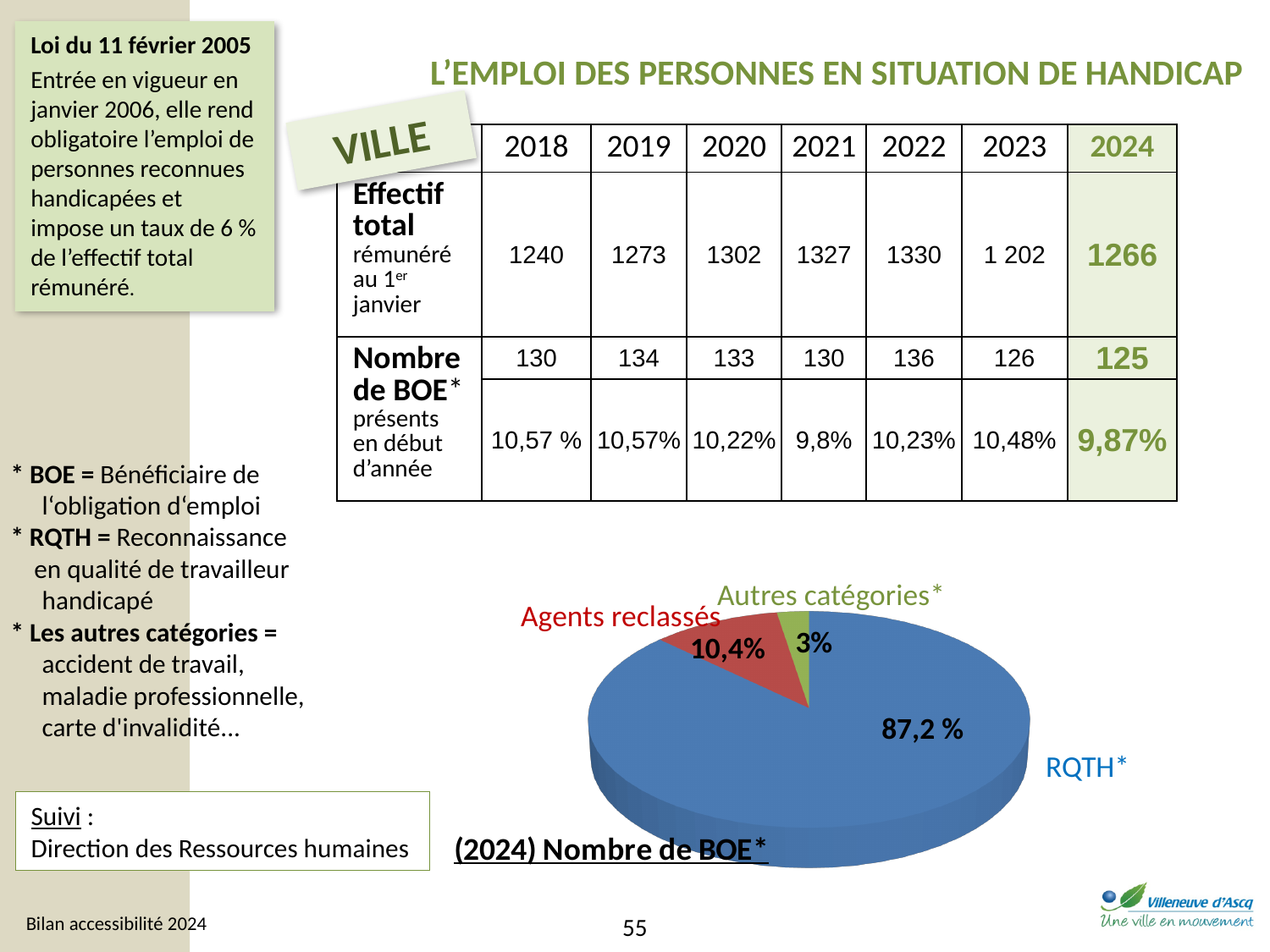
Which is larger in the pie chart, Agents reclassés or Autres catégories*? Agents reclassés What is the title of the pie chart? (2024) Nombre de BOE* Which category has the largest slice in the pie chart? RQTH* What share of the pie chart does Agents reclassés represent? 10,4% What share of the pie chart does Autres catégories* represent? 3% Which category has the smallest slice in the pie chart? Autres catégories* How many slices does the pie chart have? 3 What colour is the RQTH* slice in the pie chart? blue What share of the pie chart does RQTH* represent? 87,2 % What kind of chart is shown on the slide? pie chart What is the difference in percentage points between the Agents reclassés slice and the Autres catégories* slice? 7,4